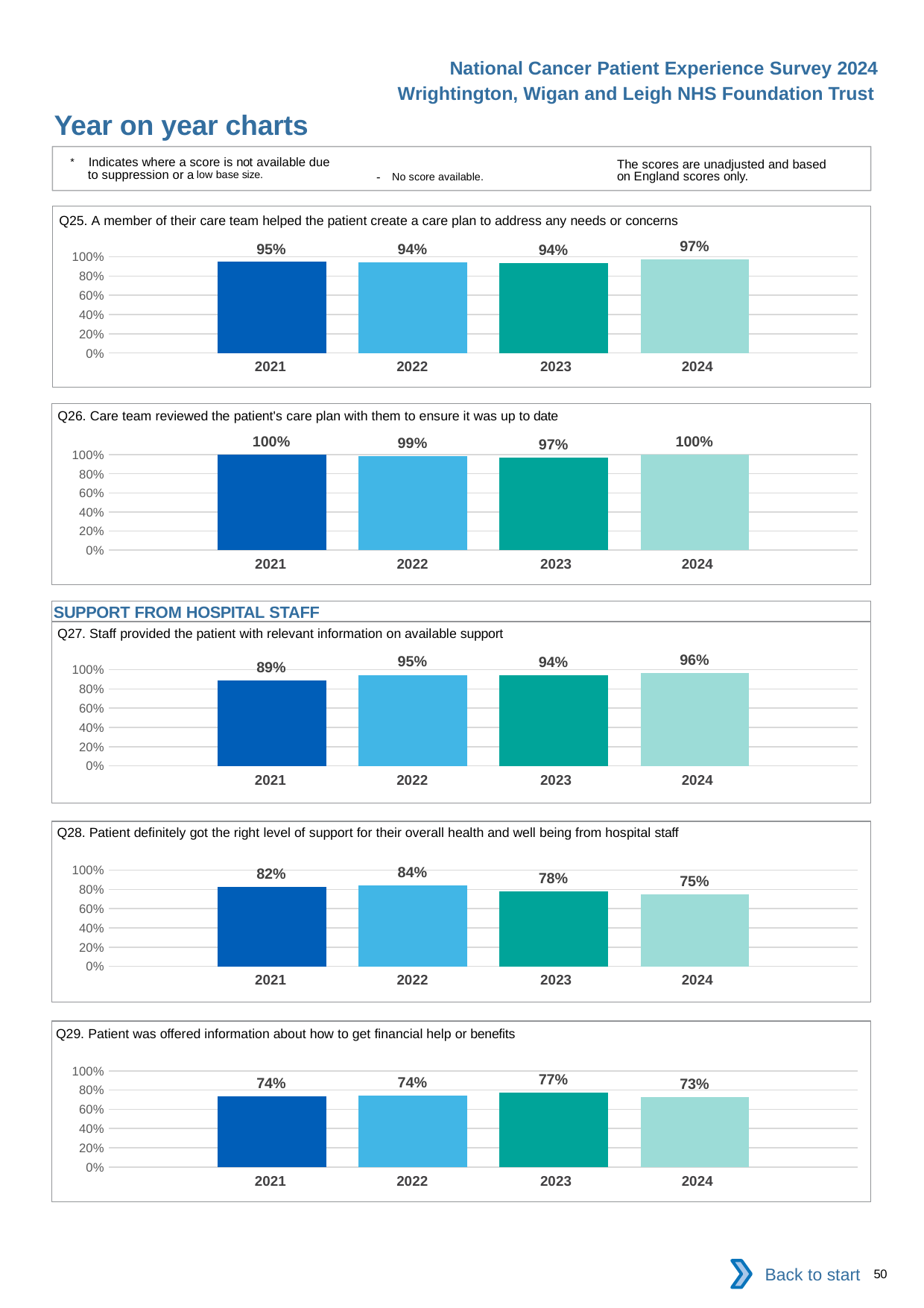
What is the section heading shown above the Q27 chart? SUPPORT FROM HOSPITAL STAFF How many years are shown in the Q25 chart? 4 In the Q28 chart, do the values rise or fall from 2022 to 2024? fall In the Q26 chart, what is the value for 2021? 100% In the Q28 chart, is the value for 2021 or 2024 larger? 2021 In the Q29 chart, what is the difference between the 2023 value and the 2024 value? 4% What kind of chart is the Q27 chart? bar chart In the Q29 chart, what is the value for 2023? 77% In the Q26 chart, which year has the lowest value? 2023 In the Q27 chart, what is the difference between the 2022 value and the 2021 value? 6% In the Q25 chart, what is the value for 2024? 97% In the Q28 chart, which year has the highest value? 2022